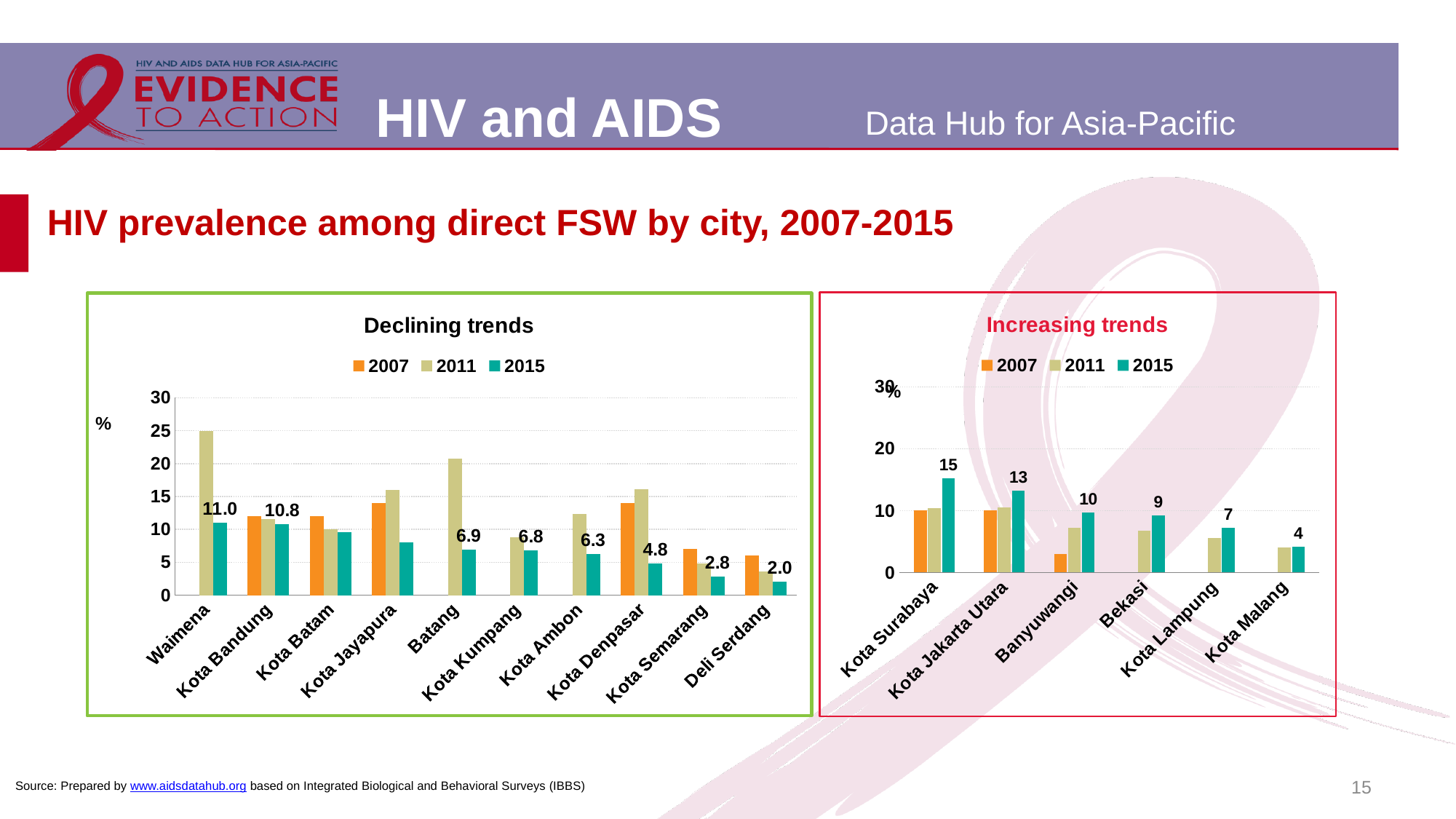
In the "Declining trends" chart, do the labelled 2015 values rise or fall from Waimena to Deli Serdang? Fall In the "Increasing trends" chart, which city has the highest 2015 value? Kota Surabaya In the "Declining trends" chart, what is the 2015 value for Kota Denpasar? 4.8 In the "Declining trends" chart, which is larger: the 2015 value for Batang or the 2015 value for Kota Ambon? Batang In the "Declining trends" chart, what is the 2015 value for Waimena? 11.0 How many cities are shown in the "Declining trends" chart? 10 In the "Increasing trends" chart, what is the difference between the 2015 values for Kota Surabaya and Kota Malang? 11 How many series does the legend of the "Increasing trends" chart list? 3 What kind of chart is the "Increasing trends" chart? Bar chart In the "Increasing trends" chart, what is the 2015 value for Kota Jakarta Utara? 13 In the "Declining trends" chart, which city has the lowest 2015 value? Deli Serdang In the "Declining trends" chart, is the 2011 value for Waimena greater or less than 20? greater